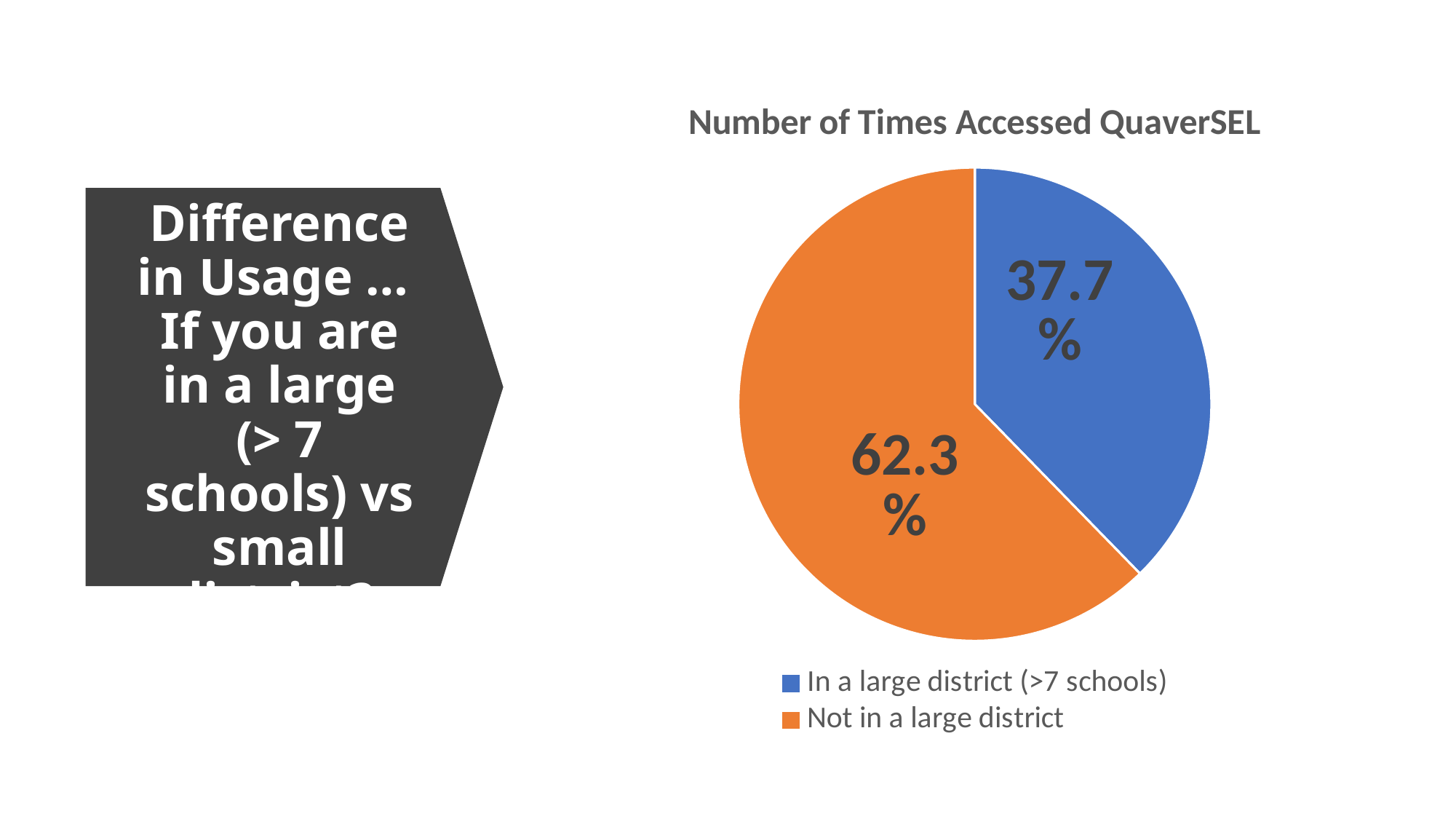
What colour is the slice for 'Not in a large district'? Orange What is the difference in percentage points between the 'Not in a large district' slice and the 'In a large district (>7 schools)' slice? 24.6 What share of the pie is labelled for 'Not in a large district'? 62.3% How many entries does the legend list? 2 What is the title of the chart? Number of Times Accessed QuaverSEL What kind of chart is shown on the slide? Pie chart Which slice of the pie is the largest? Not in a large district How many slices does the pie chart have? 2 What share of the pie is labelled for 'In a large district (>7 schools)'? 37.7% Which slice of the pie is the smallest? In a large district (>7 schools) Which is larger: the share for 'In a large district (>7 schools)' or the share for 'Not in a large district'? Not in a large district